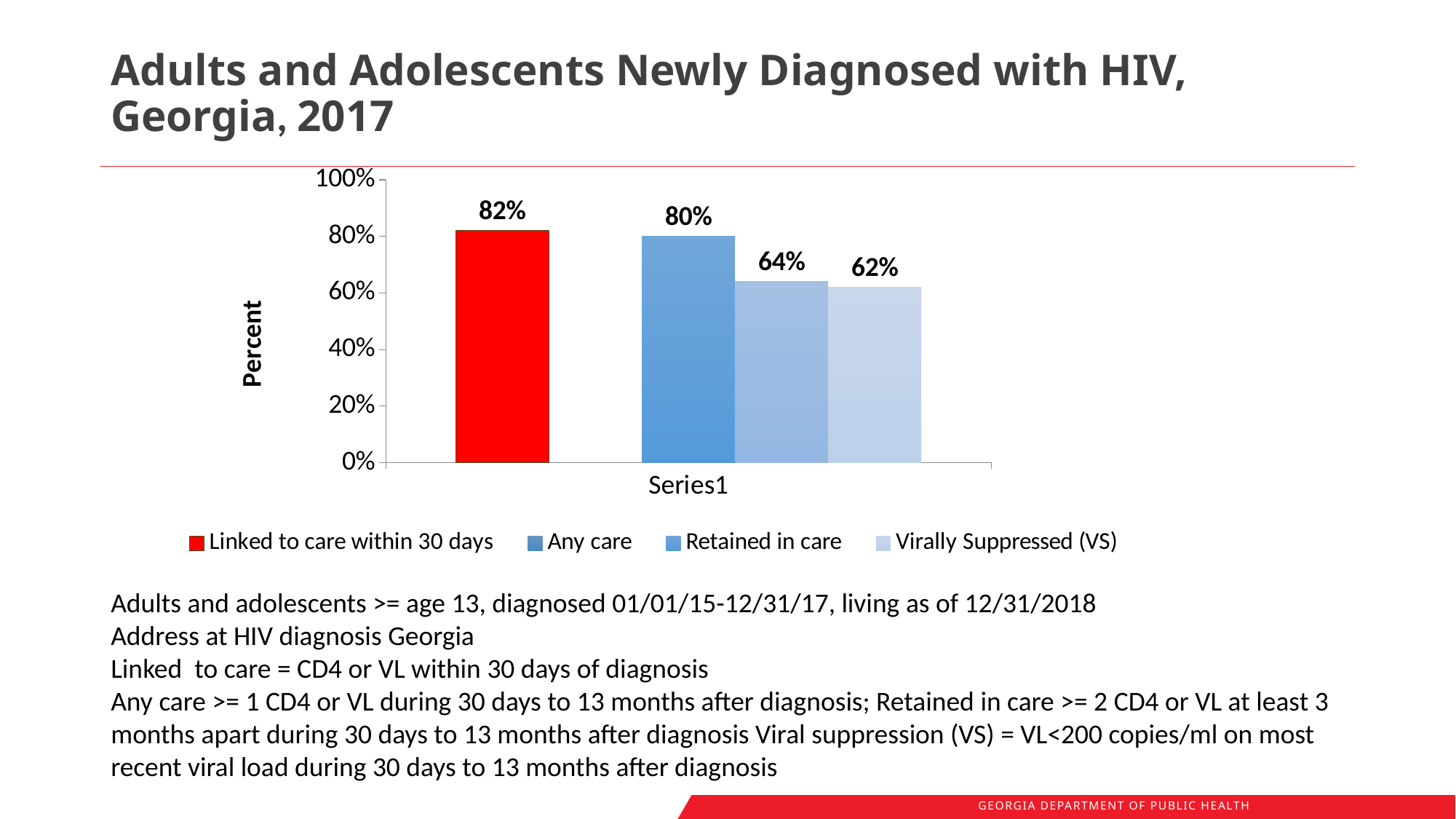
Which series has the lowest value? Virally Suppressed (VS) What is the value for Retained in care? 64% What is the difference between the Linked to care within 30 days value and the Virally Suppressed (VS) value? 20% What is the value for Linked to care within 30 days? 82% Which is larger, the value for Any care or the value for Retained in care? Any care What is the value for Any care? 80% What is the label on the vertical axis of the chart? Percent What is the difference between the Any care value and the Retained in care value? 16% Which series has the highest value? Linked to care within 30 days What is the value for Virally Suppressed (VS)? 62% How many series does the legend list? 4 What kind of chart is shown on the slide? Bar chart